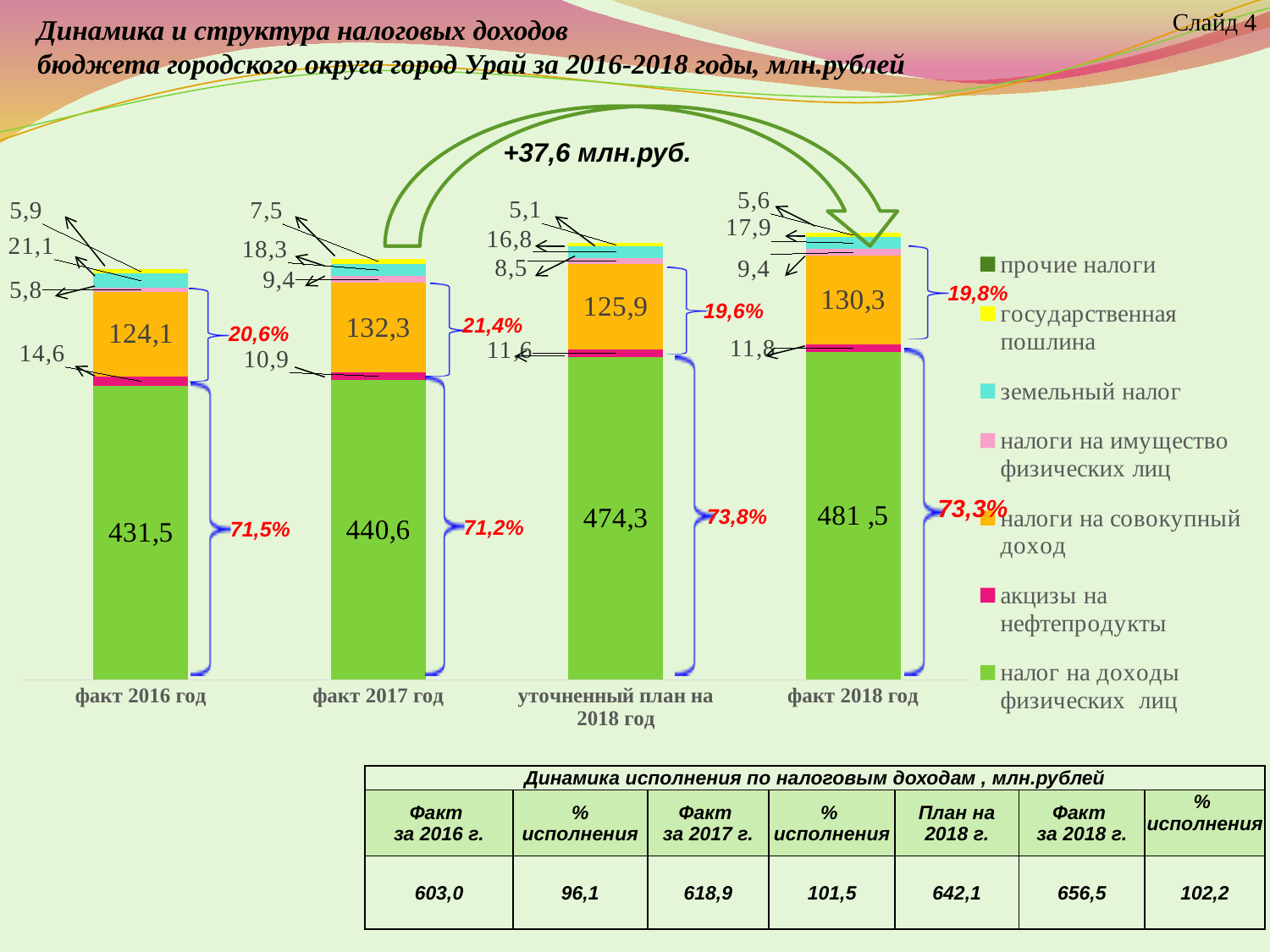
What type of chart is shown on the slide? stacked bar chart Does налог на доходы физических лиц rise or fall from факт 2016 год to факт 2018 год? rise Which is larger: налоги на совокупный доход for факт 2018 год or for уточненный план на 2018 год? факт 2018 год In which category is налог на доходы физических лиц the highest? факт 2018 год What is the difference in налог на доходы физических лиц between факт 2018 год and факт 2017 год? 40,9 What is the value of акцизы на нефтепродукты for факт 2018 год? 11,8 What is the value of налог на доходы физических лиц for факт 2016 год? 431,5 How many series does the chart legend list? 7 In which category is налог на доходы физических лиц the lowest? факт 2016 год What is the value of налог на доходы физических лиц for уточненный план на 2018 год? 474,3 What is the value of налоги на совокупный доход for факт 2017 год? 132,3 How many categories (bars) are shown along the x axis? 4